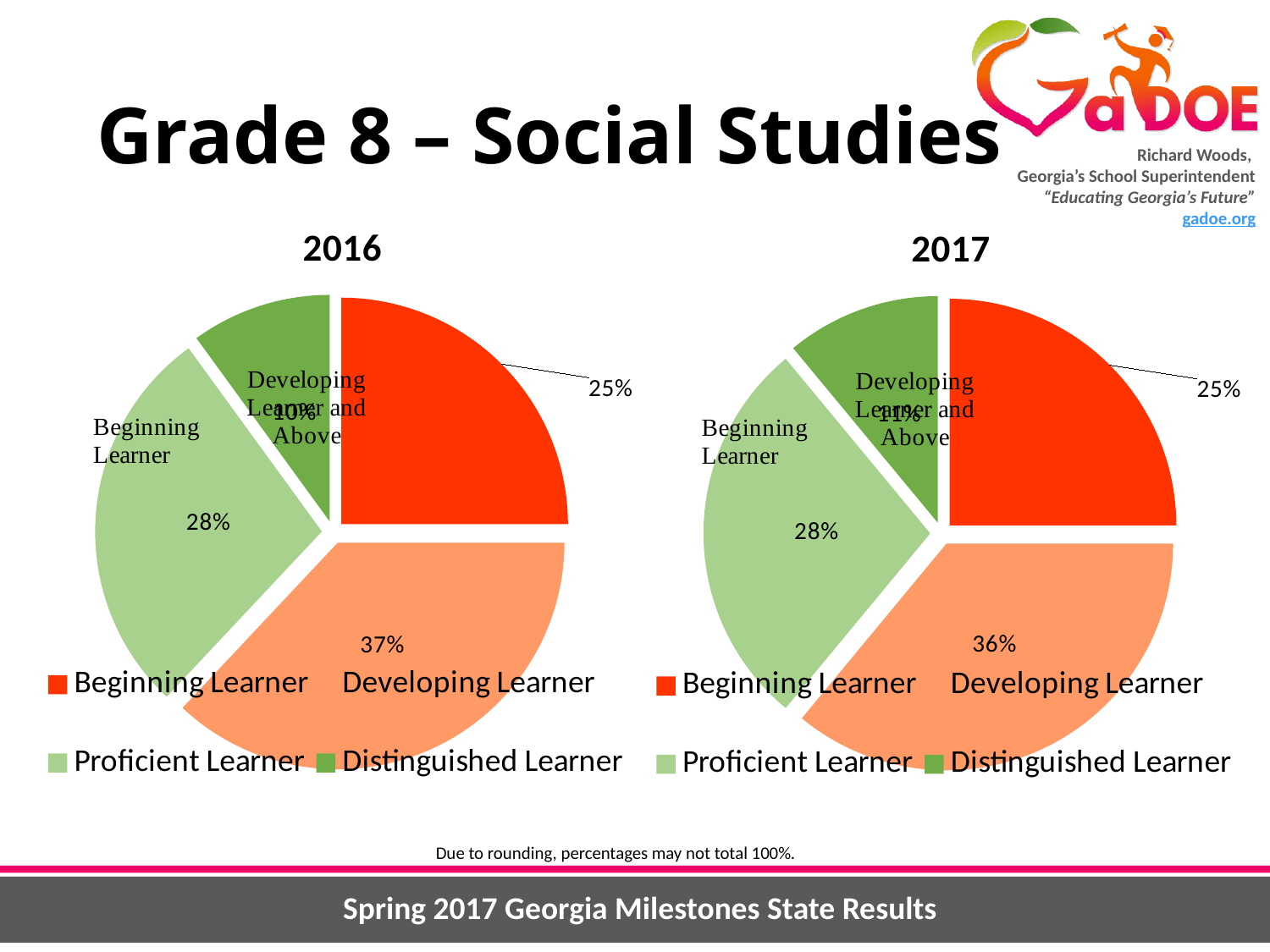
In the 2017 pie chart, what percentage is shown for Distinguished Learner? 11% In the 2017 pie chart, what percentage is shown for Developing Learner? 36% How many categories does the legend of the 2017 pie chart list? 4 In the 2016 pie chart, what percentage is shown for Beginning Learner? 25% In the 2017 pie chart, what percentage is shown for Proficient Learner? 28% What colour represents Beginning Learner in the legends? red In the 2016 pie chart, which category has the largest share? Developing Learner In the 2016 pie chart, what is the difference between the Developing Learner and Beginning Learner percentages? 12% In the 2017 pie chart, which category has the smallest share? Distinguished Learner In the 2017 pie chart, which is larger, Proficient Learner or Beginning Learner? Proficient Learner What kind of chart is used for the 2016 data? pie chart In the 2016 pie chart, what percentage is shown for Developing Learner? 37%